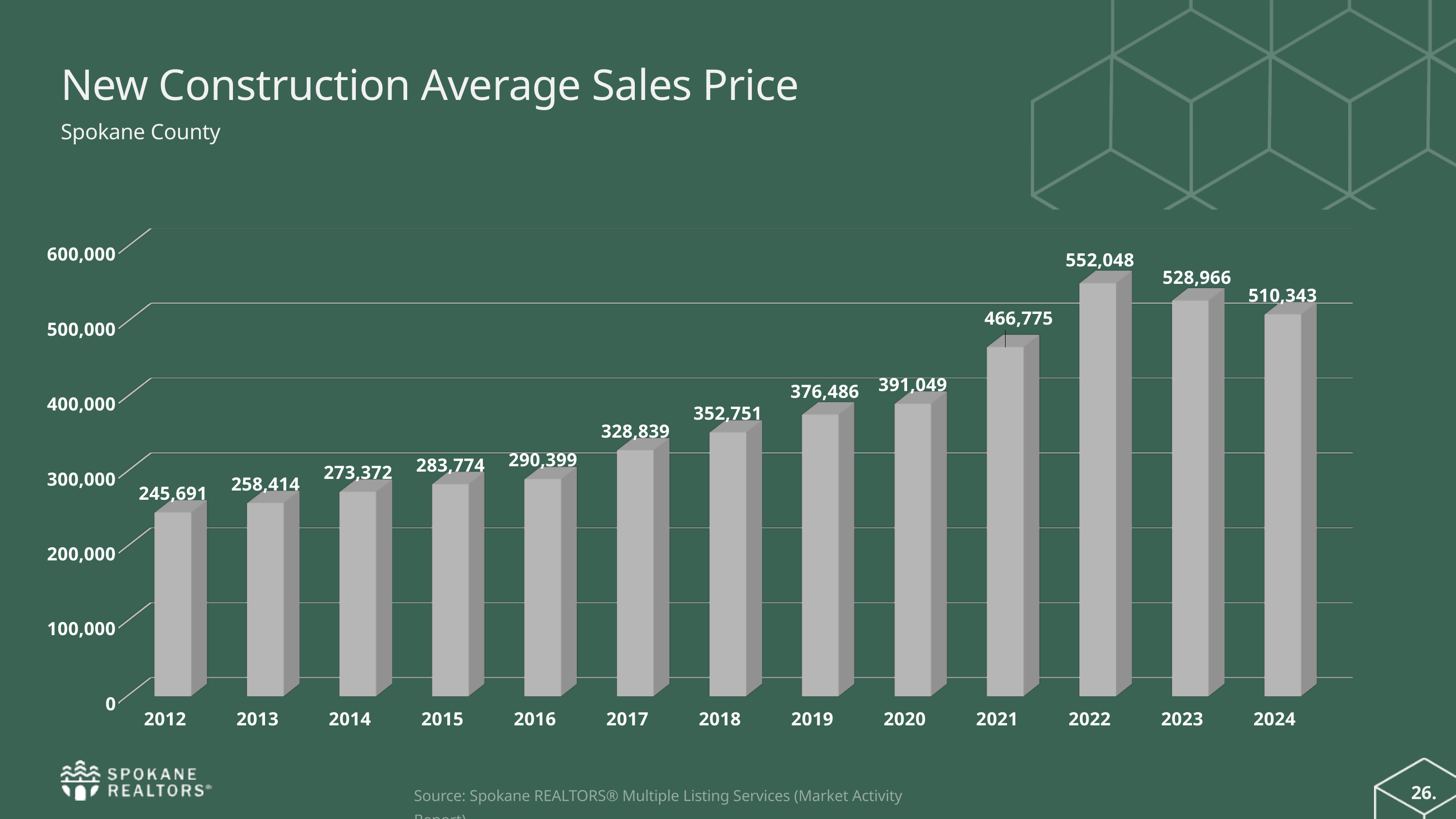
What is the new construction average sales price for 2024? 510,343 Which year has a higher average sales price, 2021 or 2024? 2024 Which year has the lowest new construction average sales price? 2012 What is the difference between the 2022 and 2023 average sales prices? 23,082 Which year has the highest new construction average sales price? 2022 What kind of chart is shown on the slide? bar chart What is the title of the chart? New Construction Average Sales Price Is the value for 2019 greater or less than 400,000? less Do the values rise or fall from 2012 to 2022? rise What is the new construction average sales price for 2020? 391,049 How many years are shown on the x axis? 13 What is the new construction average sales price for 2012? 245,691